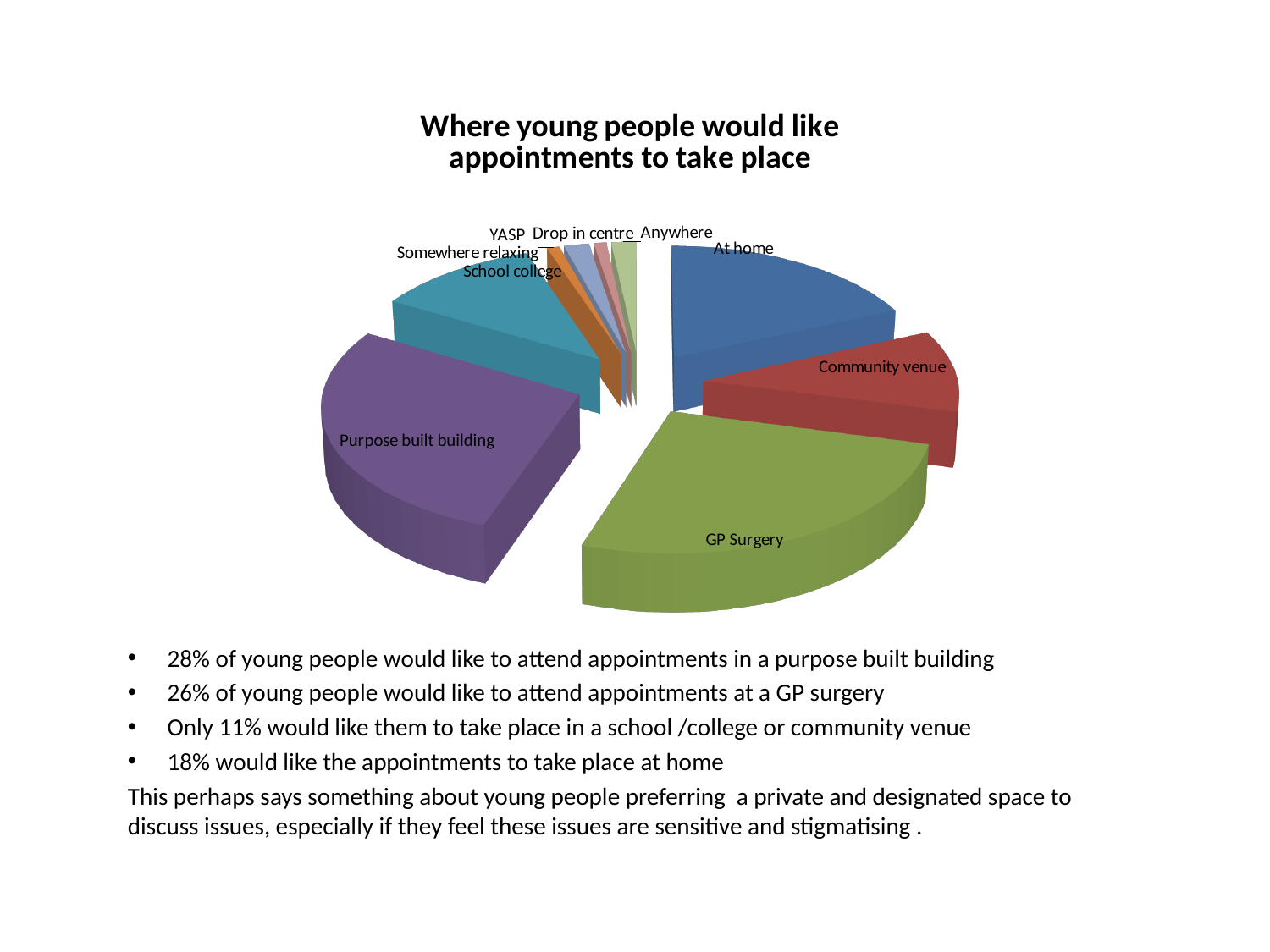
What is the title of the chart? Where young people would like appointments to take place Using the percentages stated on the slide, how much larger is the share for purpose built building than for at home? 10% What kind of chart is shown on the slide? pie chart Which slice is larger, At home or Community venue? At home According to the slide, what percentage of young people would like appointments in a purpose built building? 28% How many slices (categories) does the pie chart have? 9 Which slice is larger, GP Surgery or Somewhere relaxing? GP Surgery According to the slide, what percentage would like appointments to take place at home? 18% Which slice is larger, Purpose built building or School college? Purpose built building According to the slide, what percentage of young people would like appointments at a GP surgery? 26% What colour is the GP Surgery slice? green